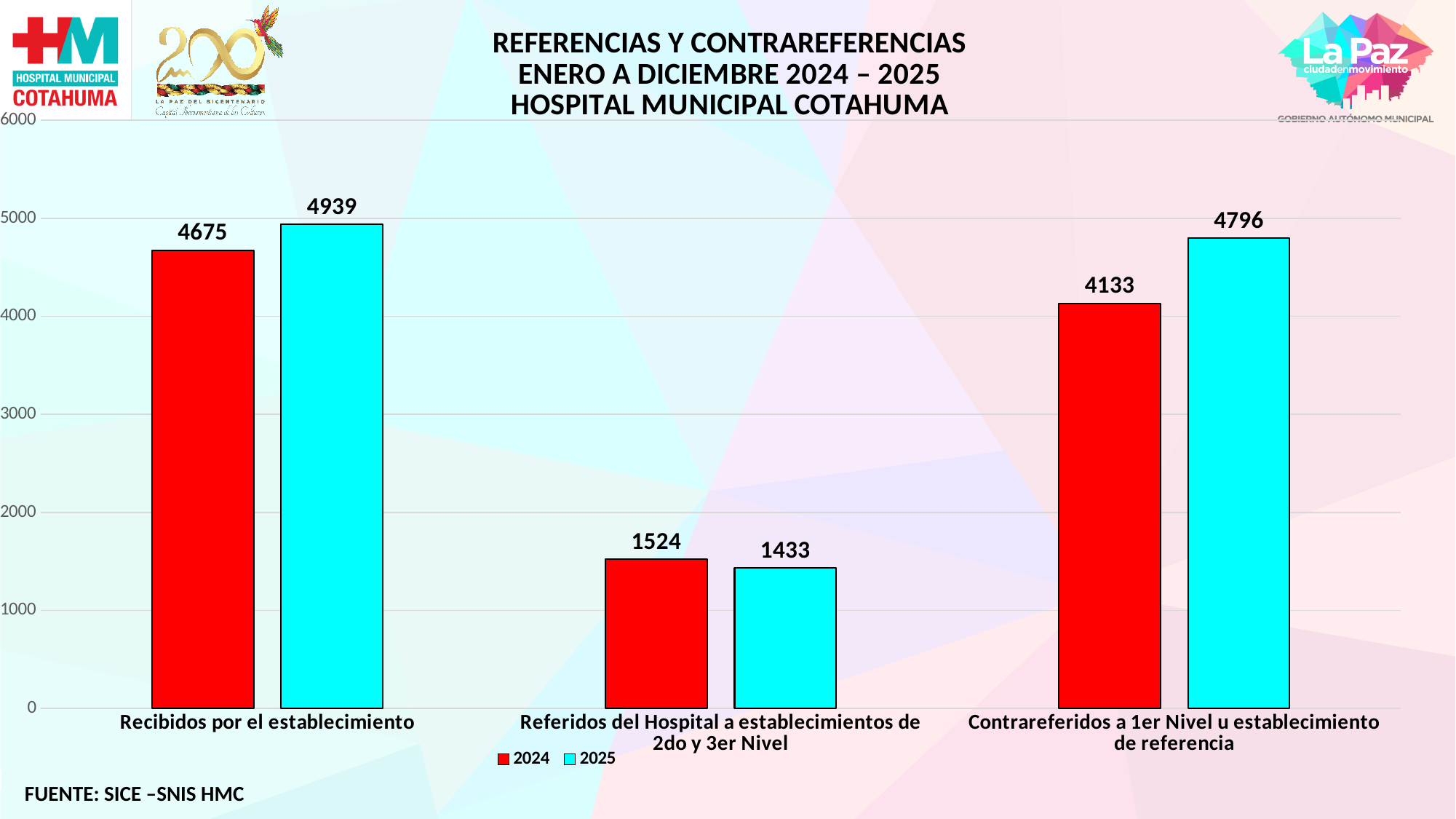
How many series does the legend list? 2 Which category has the highest 2025 value? Recibidos por el establecimiento What is the 2024 value for 'Recibidos por el establecimiento'? 4675 What is the 2025 value for 'Contrareferidos a 1er Nivel u establecimiento de referencia'? 4796 How many categories are shown on the x axis? 3 Is the 2024 value for 'Contrareferidos a 1er Nivel u establecimiento de referencia' greater or less than 4000? greater What is the difference between the 2025 and 2024 values for 'Recibidos por el establecimiento'? 264 What is the difference between the 2025 and 2024 values for 'Contrareferidos a 1er Nivel u establecimiento de referencia'? 663 What is the 2025 value for 'Referidos del Hospital a establecimientos de 2do y 3er Nivel'? 1433 What kind of chart is shown on the slide? Bar chart For 'Referidos del Hospital a establecimientos de 2do y 3er Nivel', which year has the larger value, 2024 or 2025? 2024 Which category has the lowest 2024 value? Referidos del Hospital a establecimientos de 2do y 3er Nivel